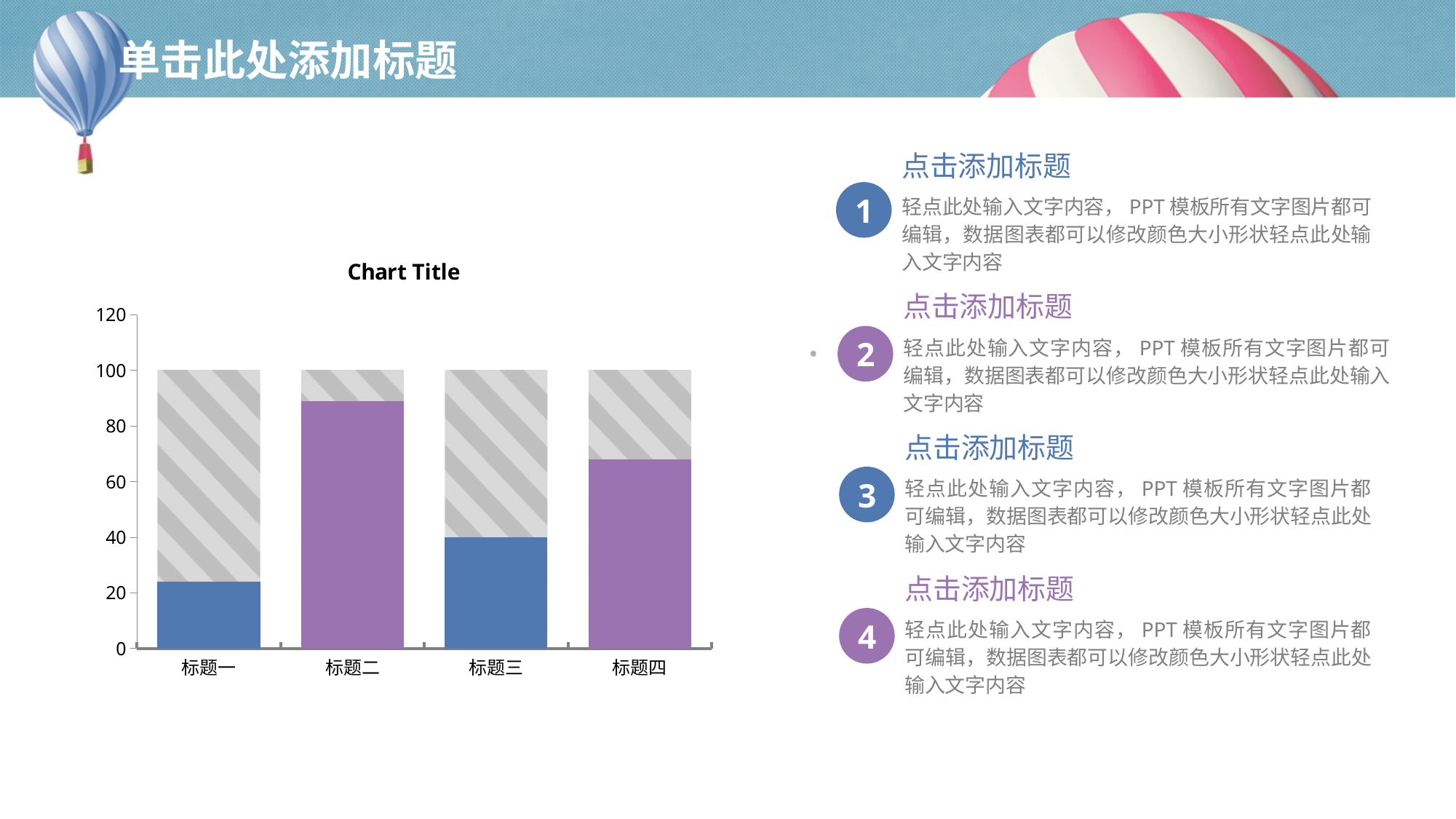
Is the coloured segment for 标题一 greater or less than 40? less How many categories are shown on the x axis of the chart? 4 What kind of chart is shown on the slide? bar chart What is the highest value shown on the vertical axis? 120 Which category has the tallest coloured (non-striped) segment? 标题二 Which has the larger coloured segment, 标题三 or 标题四? 标题四 Which category has the shortest coloured (non-striped) segment? 标题一 What is the title of the chart? Chart Title Is the coloured segment for 标题四 greater or less than 60? greater What is the total height of the stacked bar for 标题一, including the striped segment? 100 Is the coloured segment for 标题三 greater or less than 60? less